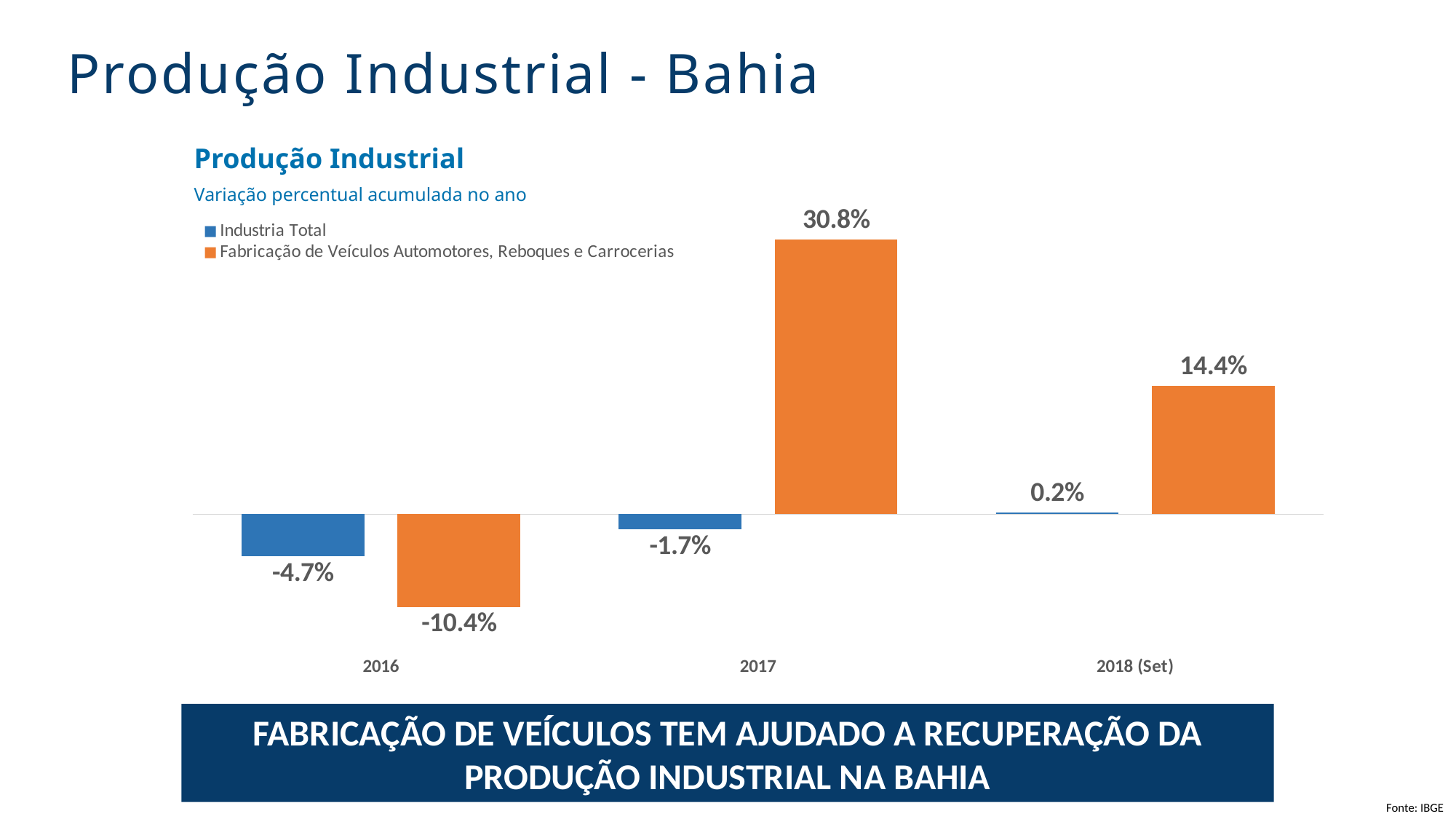
In which year is the Industria Total value lowest? 2016 What is the value for Industria Total in 2018 (Set)? 0.2% What is the value for Fabricação de Veículos Automotores, Reboques e Carrocerias in 2017? 30.8% What is the value for Fabricação de Veículos Automotores, Reboques e Carrocerias in 2016? -10.4% Which is larger in 2017: Industria Total or Fabricação de Veículos Automotores, Reboques e Carrocerias? Fabricação de Veículos Automotores, Reboques e Carrocerias In which year does Fabricação de Veículos Automotores, Reboques e Carrocerias reach its highest value? 2017 What is the value for Industria Total in 2016? -4.7% How many series does the legend list? 2 Does the Industria Total value rise or fall from 2016 to 2018 (Set)? Rise What is the difference between the Fabricação de Veículos value in 2017 and in 2018 (Set)? 16.4 percentage points How many year categories are shown on the x axis? 3 What kind of chart is shown on the slide? Bar chart